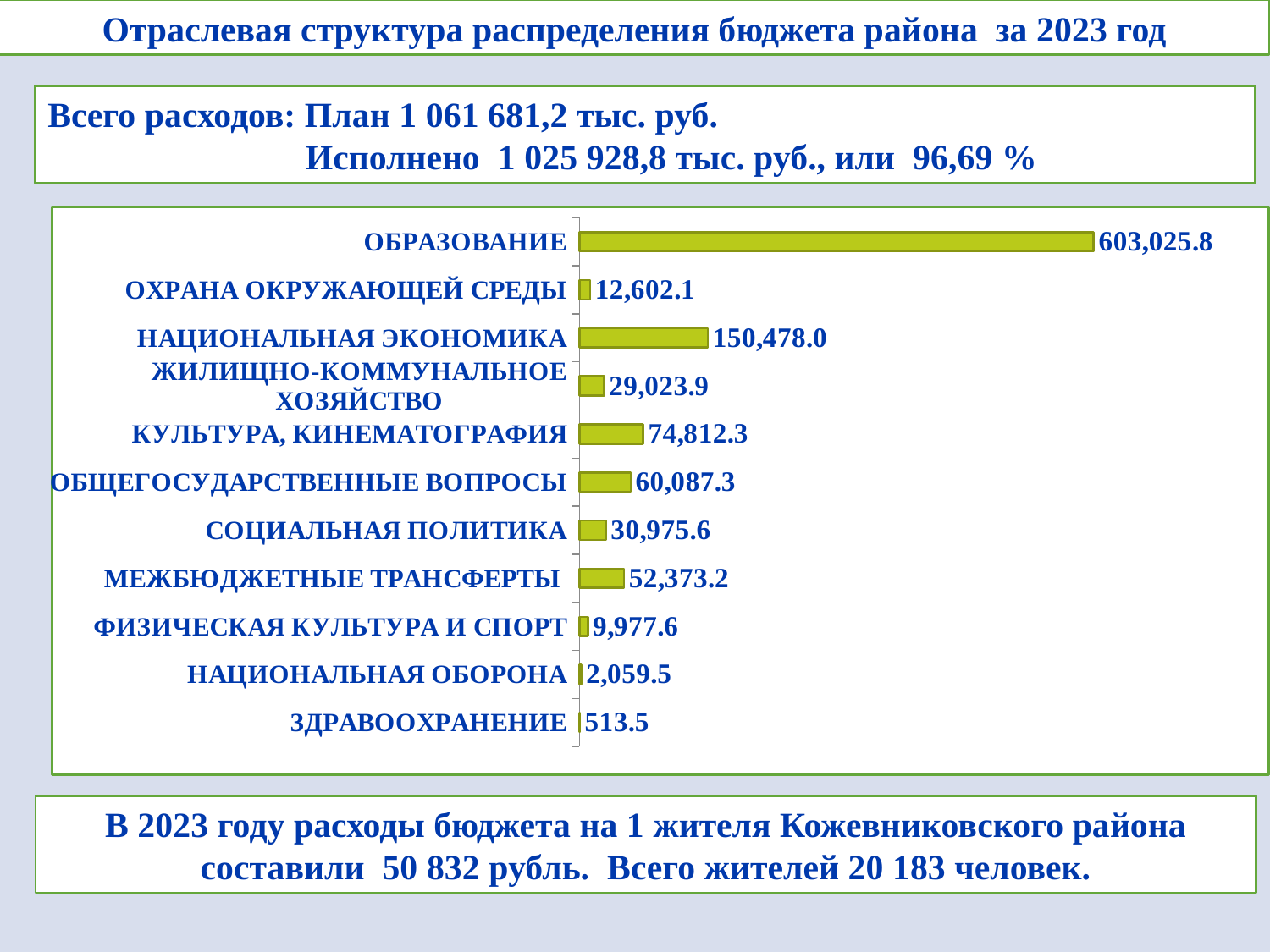
Which is larger: the value for ОХРАНА ОКРУЖАЮЩЕЙ СРЕДЫ or the value for ФИЗИЧЕСКАЯ КУЛЬТУРА И СПОРТ? ОХРАНА ОКРУЖАЮЩЕЙ СРЕДЫ How many categories are shown in the chart? 11 Which category has the highest value? ОБРАЗОВАНИЕ What is the value shown for НАЦИОНАЛЬНАЯ ЭКОНОМИКА? 150,478.0 Which category has the lowest value? ЗДРАВООХРАНЕНИЕ What kind of chart is shown on the slide? Bar chart What is the value shown for ОБРАЗОВАНИЕ? 603,025.8 Which is larger: the value for СОЦИАЛЬНАЯ ПОЛИТИКА or the value for ЖИЛИЩНО-КОММУНАЛЬНОЕ ХОЗЯЙСТВО? СОЦИАЛЬНАЯ ПОЛИТИКА What is the difference between the values for НАЦИОНАЛЬНАЯ ЭКОНОМИКА and МЕЖБЮДЖЕТНЫЕ ТРАНСФЕРТЫ? 98,104.8 What is the value shown for МЕЖБЮДЖЕТНЫЕ ТРАНСФЕРТЫ? 52,373.2 What is the difference between the values for КУЛЬТУРА, КИНЕМАТОГРАФИЯ and ОБЩЕГОСУДАРСТВЕННЫЕ ВОПРОСЫ? 14,725.0 What is the value shown for ЗДРАВООХРАНЕНИЕ? 513.5